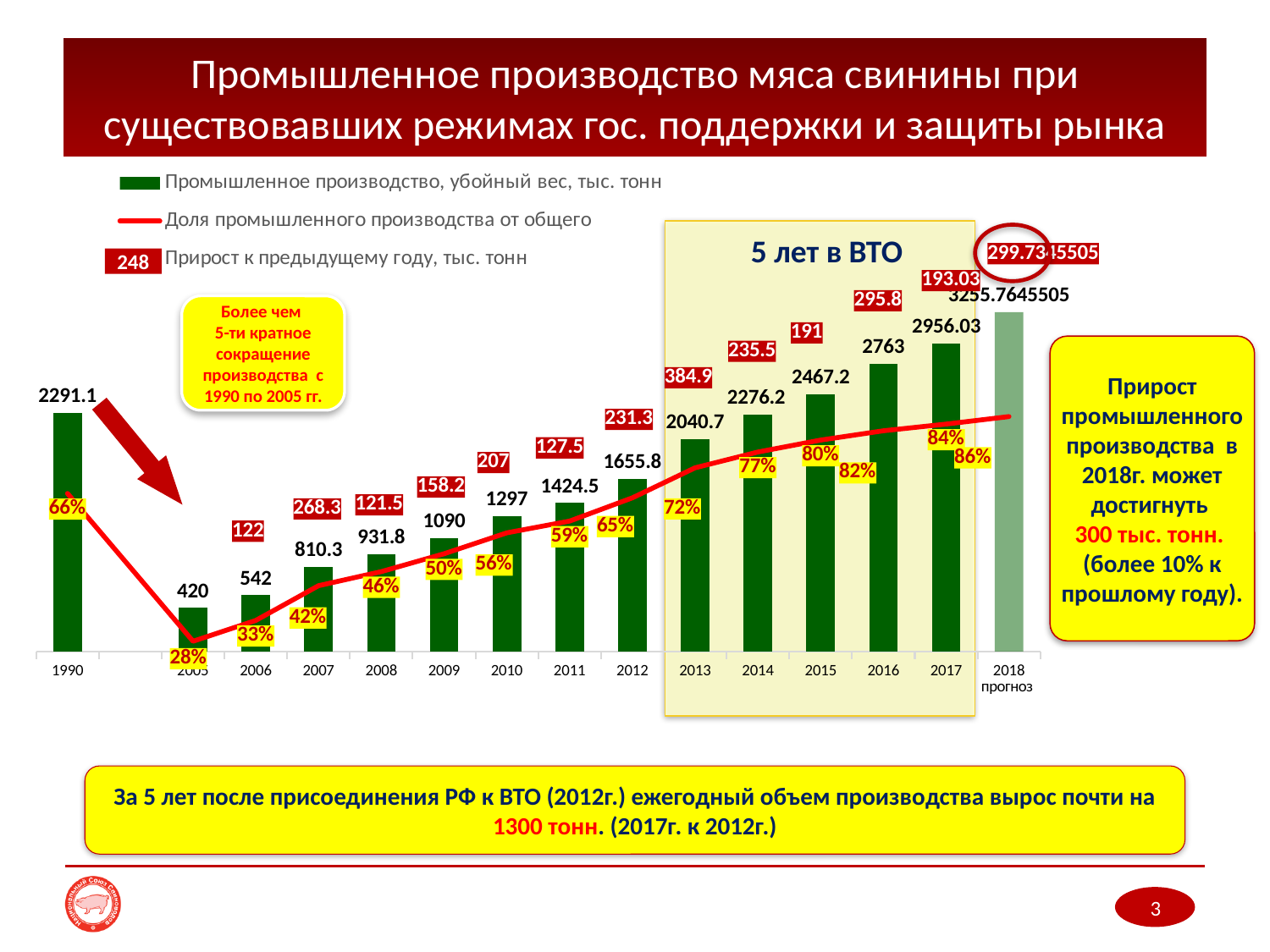
What is the industrial pork production value (thousand tonnes) shown for 2012? 1655.8 Does the share of industrial production (red line) rise or fall from 2005 to 2018? rise Which year between 2005 and 2017 has the lowest industrial production bar? 2005 What is the industrial pork production value shown for 2017? 2956.03 Which year has the highest share of industrial production on the red line? 2018 How many series does the legend list? 3 How many years are shown on the x axis? 15 What share of total production does industrial production have in 2005, according to the red line label? 28% Which is larger: the industrial production value for 1990 or for 2013? 1990 What kind of chart is used for the industrial production series? bar chart What is the growth to the previous year (red box label) shown for 2013? 384.9 What is the difference between the industrial production values for 2017 and 2012? 1300.23